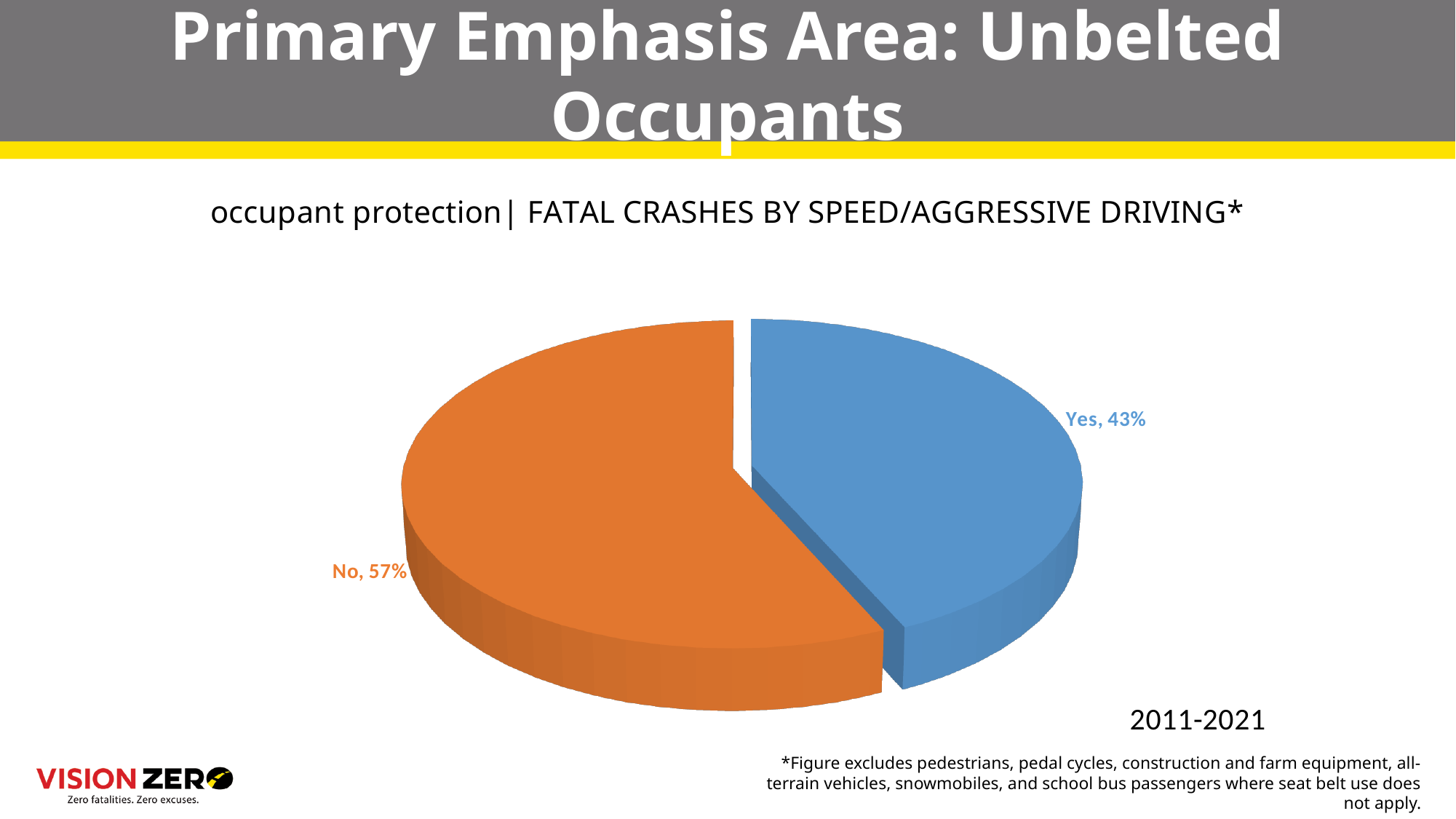
What share of fatal crashes did not involve speed/aggressive driving (No)? 57% What share of fatal crashes involved speed/aggressive driving (Yes)? 43% Which slice of the pie is the largest? No Which slice of the pie is the smallest? Yes Which is larger, the Yes slice or the No slice? No How many slices does the pie chart have? 2 What kind of chart is shown on the slide? Pie chart What is the difference in percentage points between the No and Yes slices? 14 What time period does the chart cover, as shown on the slide? 2011-2021 What is the share of the pie represented by the Yes slice? 43% What colour is the No slice of the pie? Orange